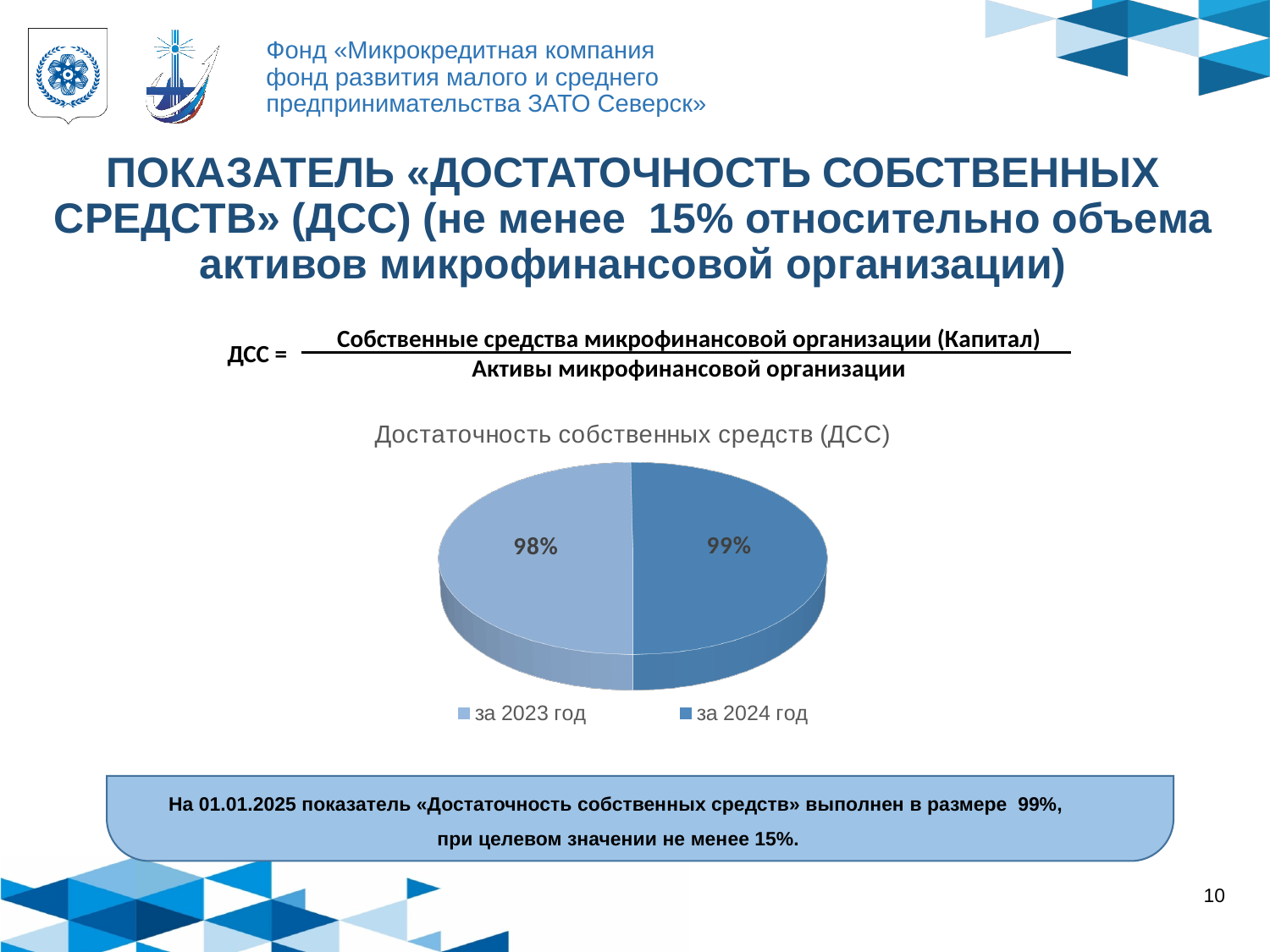
What is the title of the chart? Достаточность собственных средств (ДСС) Which year has the lower value in the chart? за 2023 год What type of chart is shown on the slide? Pie chart Is the value for «за 2023 год» larger or smaller than the value for «за 2024 год»? Smaller What is the difference between the values for «за 2024 год» and «за 2023 год»? 1% What value is shown for «за 2023 год» in the chart? 98% What value is shown for «за 2024 год» in the chart? 99% How many entries does the chart legend list? 2 Which year has the higher value in the chart? за 2024 год Which legend entry is shown in the darker blue colour? за 2024 год How many slices does the pie chart have? 2